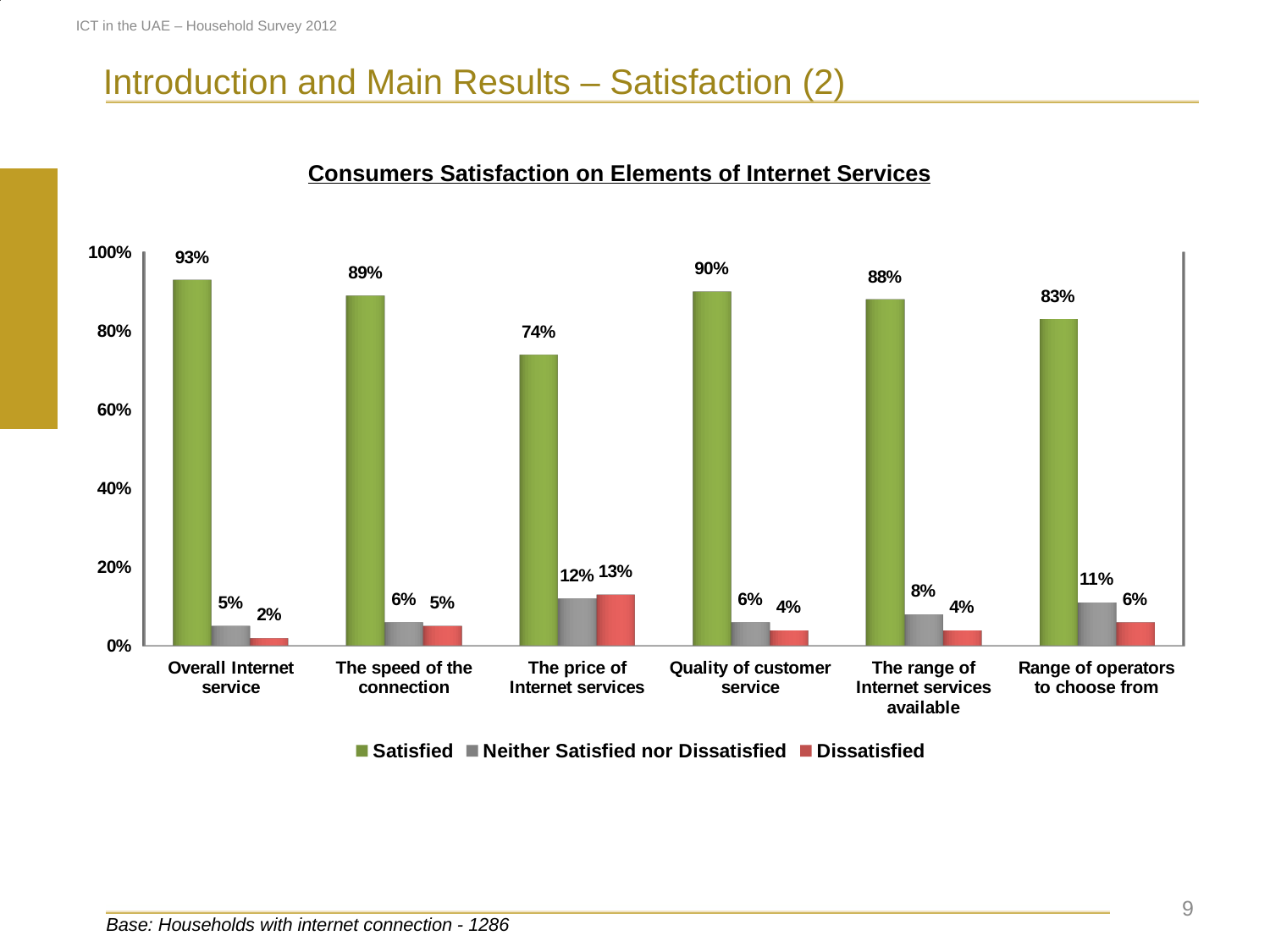
How many categories are shown on the x axis? 6 What is the Neither Satisfied nor Dissatisfied value for the range of operators to choose from? 11% What is the title of the chart? Consumers Satisfaction on Elements of Internet Services How many series does the legend list? 3 What kind of chart is shown on the slide? Bar chart What is the Dissatisfied value for the price of Internet services? 13% Which category has the highest Satisfied percentage? Overall Internet service What percentage of consumers are satisfied with the overall Internet service? 93% Which colour represents the Dissatisfied series? Red What is the difference between the Satisfied percentages for overall Internet service and the price of Internet services? 19% Which is larger: the Satisfied value for quality of customer service or for the range of Internet services available? Quality of customer service Which category has the lowest Satisfied percentage? The price of Internet services